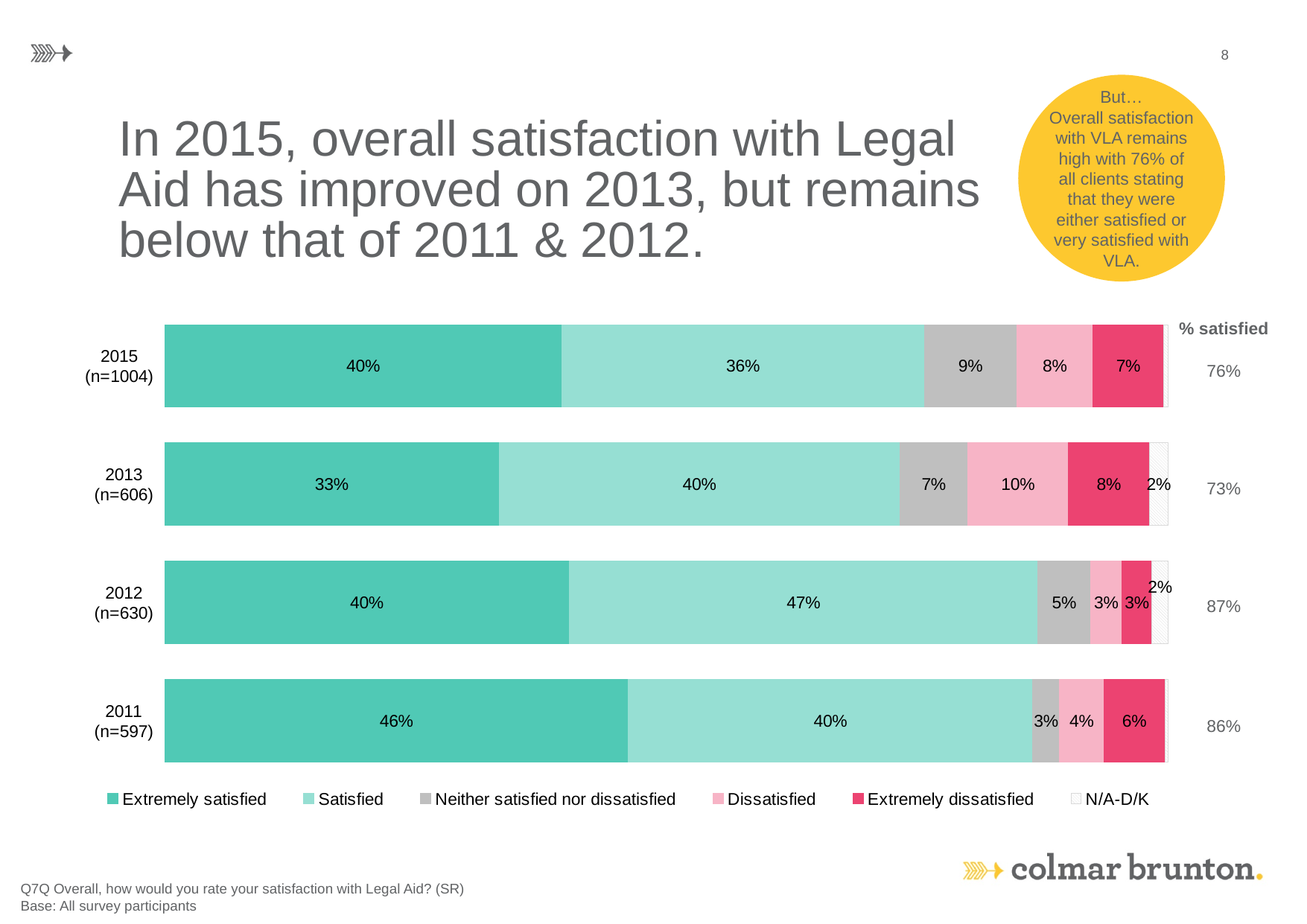
How many series does the legend list? 6 Which year has the larger Neither satisfied nor dissatisfied value, 2015 or 2013? 2015 What percentage of clients were Dissatisfied in 2013 (n=606)? 10% What is the % satisfied figure shown for 2012 (n=630)? 87% Which year has the lowest Extremely dissatisfied percentage? 2012 (n=630) What is the total of the labelled segments in the 2015 (n=1004) bar? 100% What percentage of clients were Extremely satisfied in 2015 (n=1004)? 40% How many percentage points higher is the Satisfied value for 2012 than for 2015? 11 percentage points How many years (bars) are shown in the chart? 4 Which year has the highest Extremely satisfied percentage? 2011 (n=597) What kind of chart is shown on the slide? Stacked bar chart What is the Satisfied value for 2012 (n=630)? 47%